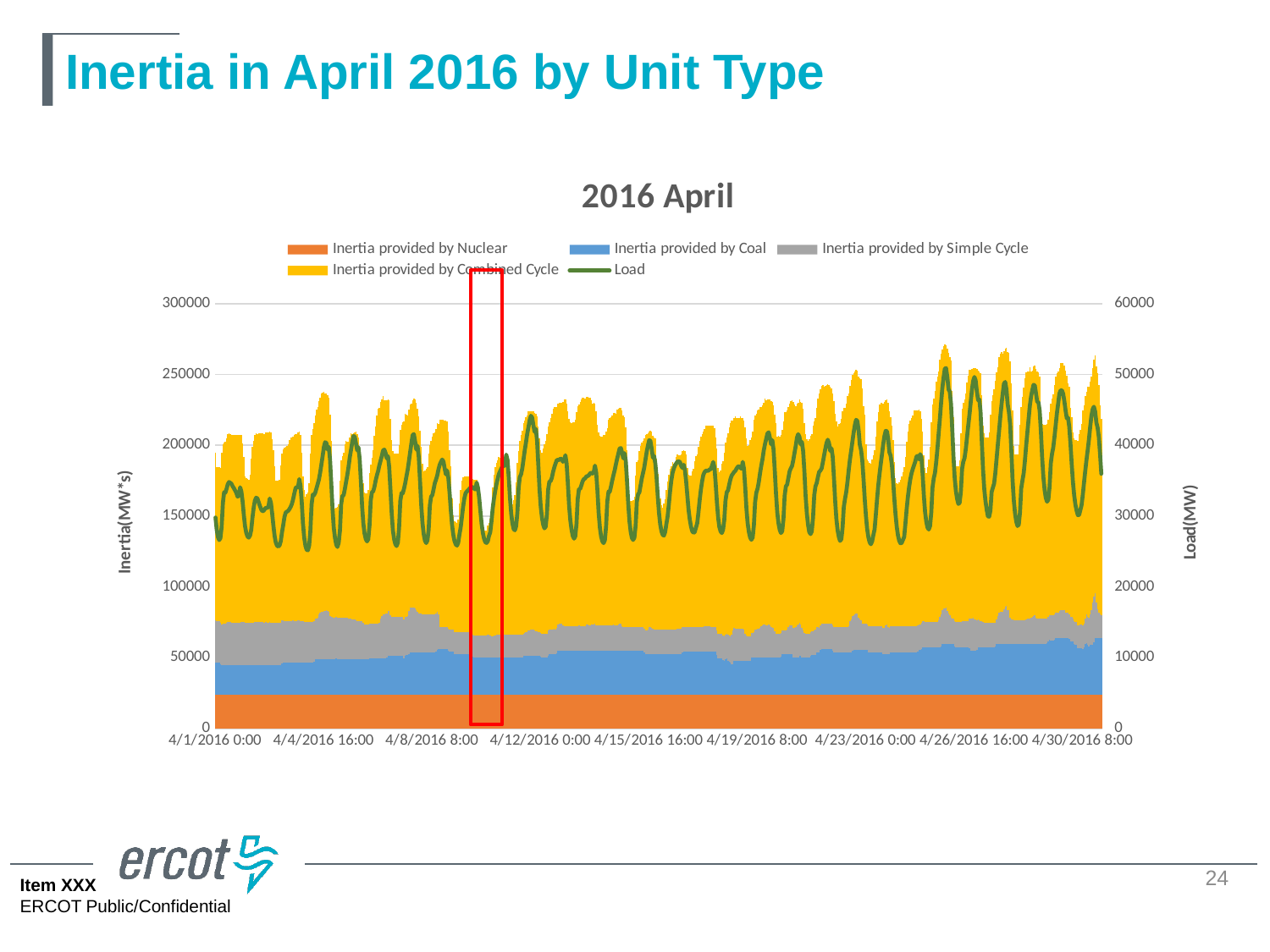
Is the inertia provided by Nuclear greater or less than 50000 MW*s? less Is the highest total inertia reached during the month greater or less than 300000 MW*s? less What is the label of the right-hand vertical axis? Load(MW) Which unit type provides the largest share of inertia throughout April 2016? Combined Cycle How many date labels are shown along the x axis? 9 What kind of chart is shown on the slide? Stacked area chart with a line series Which provides more inertia, Combined Cycle or Coal? Combined Cycle How many series does the legend of the '2016 April' chart list? 5 What is the title of the chart on the slide? 2016 April Do the daily Load peaks generally rise or fall over the course of April 2016? rise Is the total inertia at the start of the month (4/1/2016 0:00) greater or less than 150000 MW*s? greater